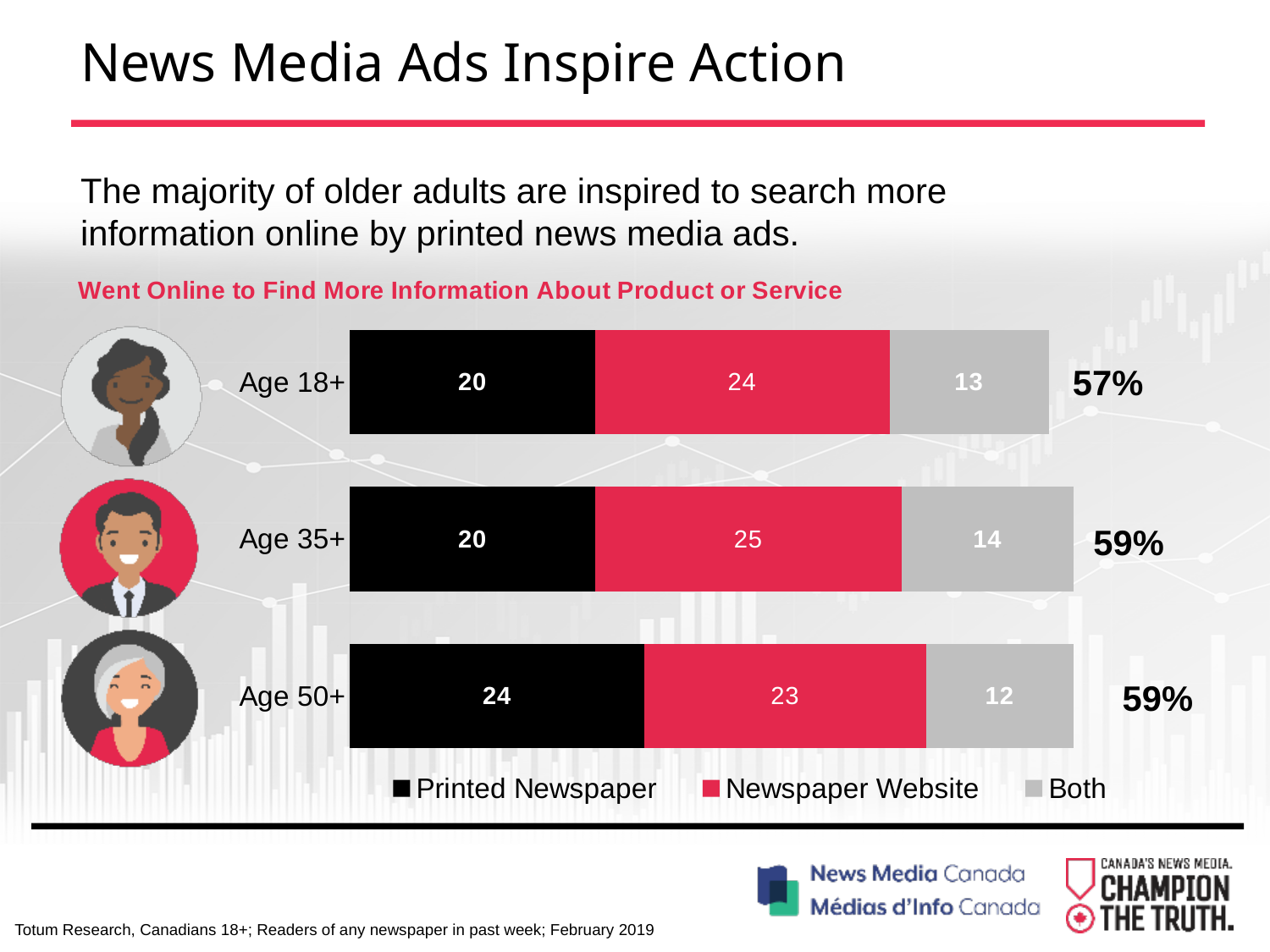
Which age group has the lowest Both value? Age 50+ What total percentage is shown at the end of the Age 18+ bar? 57% What is the Both value for Age 18+? 13 What is the Newspaper Website value for Age 35+? 25 What is the difference between the Newspaper Website values for Age 35+ and Age 50+? 2 Which age group has the highest Printed Newspaper value? Age 50+ How many age groups are shown in the chart? 3 Which is larger for Age 18+: the Printed Newspaper value or the Newspaper Website value? Newspaper Website What total percentage is shown at the end of the Age 50+ bar? 59% How many series does the legend list? 3 What is the Printed Newspaper value for Age 50+? 24 What type of chart is shown on the slide? Stacked bar chart